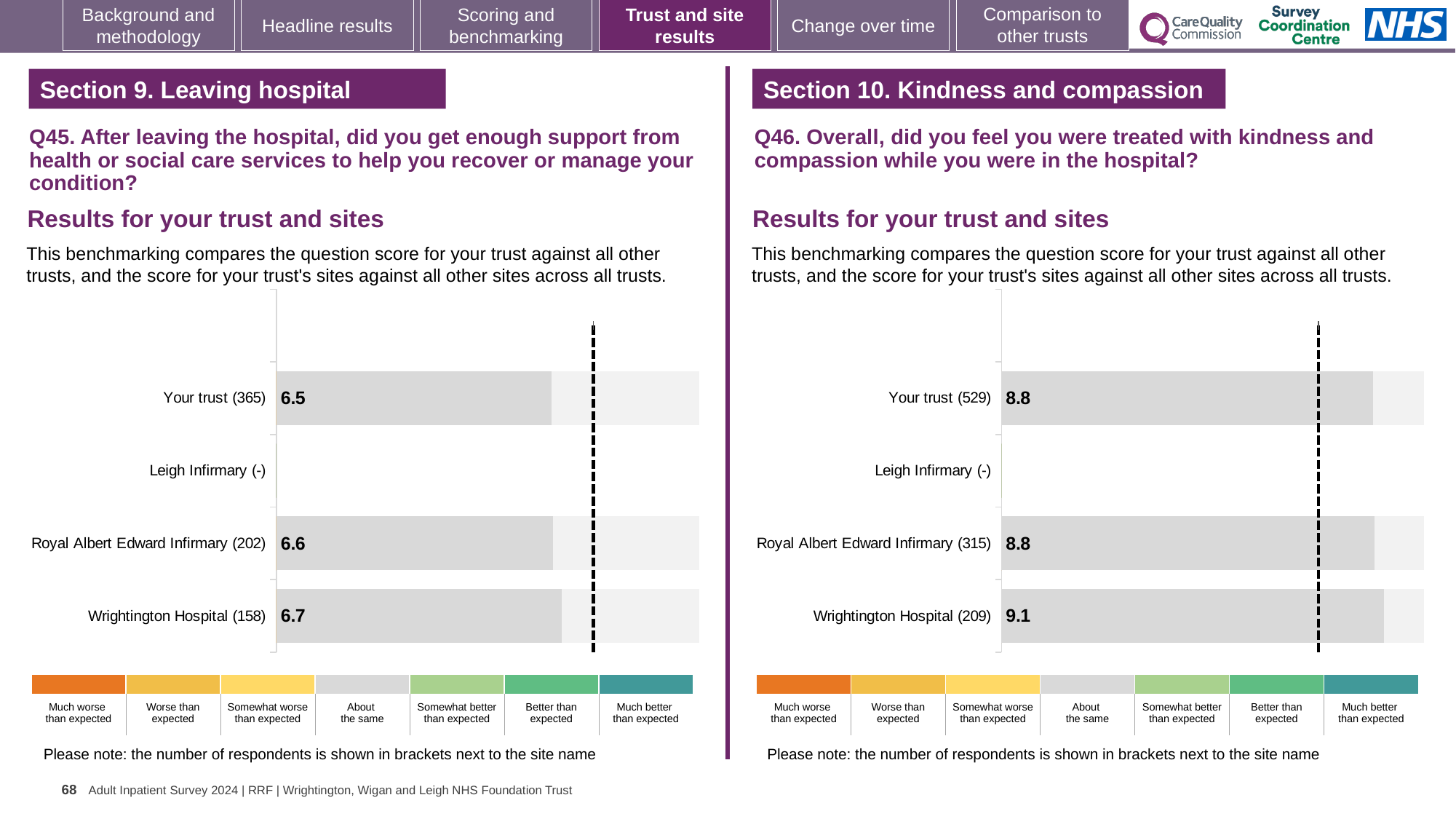
In the Q46 chart on the right, what is the score for Royal Albert Edward Infirmary (315)? 8.8 In the Q46 chart on the right, what is the difference between the scores for Wrightington Hospital (209) and Your trust (529)? 0.3 In the Q46 chart on the right, what is the score for Wrightington Hospital (209)? 9.1 In the Q45 chart on the left, which has the larger score, Royal Albert Edward Infirmary (202) or Your trust (365)? Royal Albert Edward Infirmary (202) In the Q45 chart on the left, what is the score for Your trust (365)? 6.5 In the Q45 chart on the left, what is the difference between the scores for Wrightington Hospital (158) and Your trust (365)? 0.2 In the Q46 chart on the right, which category has the highest score? Wrightington Hospital (209) In the Q45 chart on the left, what is the score for Wrightington Hospital (158)? 6.7 How many categories are listed on the y axis of the Q46 chart on the right? 4 In the Q45 chart on the left, which category has the highest score? Wrightington Hospital (158) What kind of chart is used for the Q45 results on the left? Bar chart In the Q45 chart on the left, which category with a score shown has the lowest score? Your trust (365)